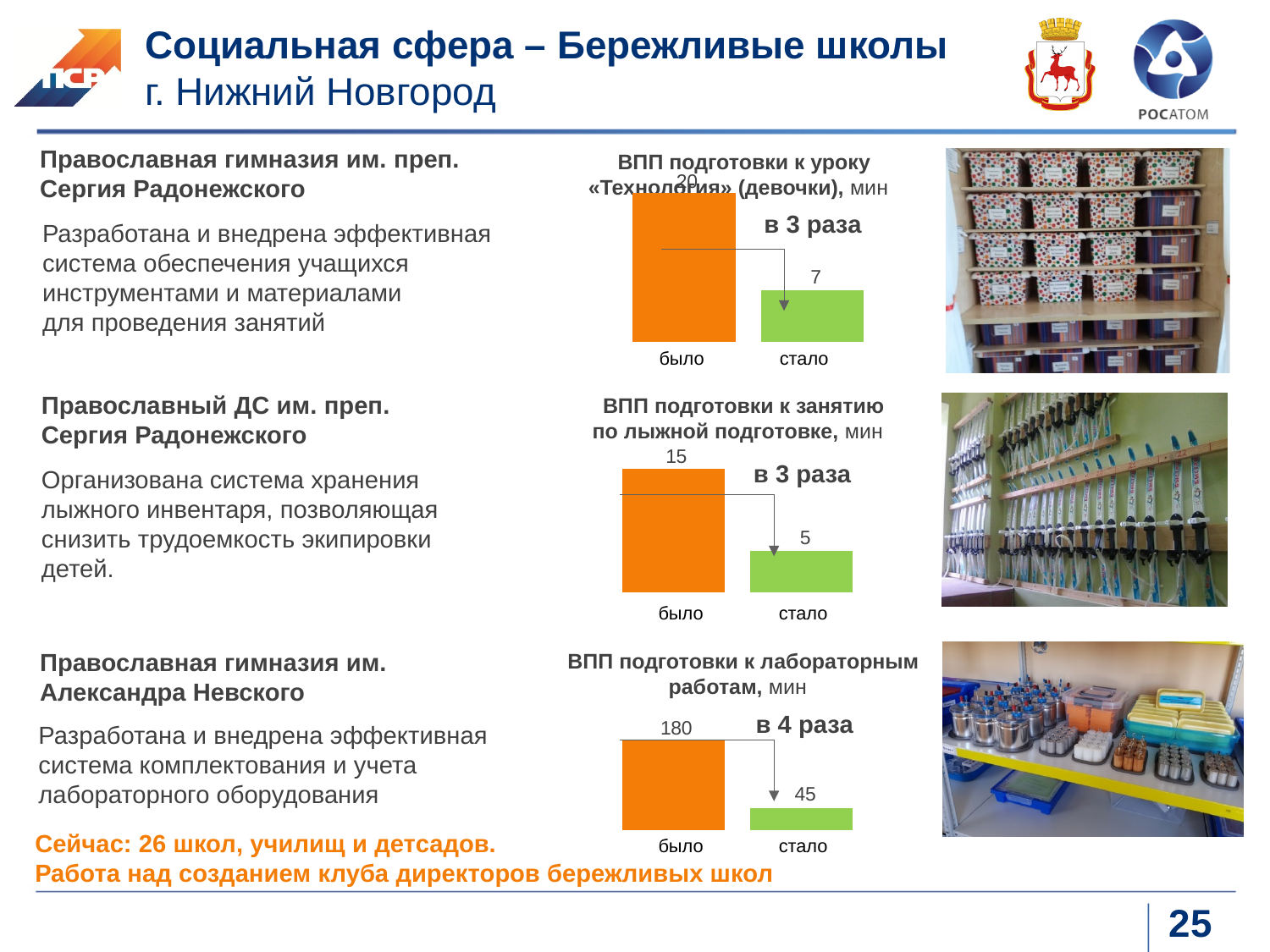
In the chart titled «ВПП подготовки к занятию по лыжной подготовке, мин», what is the difference between «было» and «стало»? 10 In the chart titled «ВПП подготовки к занятию по лыжной подготовке, мин», what is the value for «стало»? 5 How many categories are shown in the chart titled «ВПП подготовки к уроку «Технология» (девочки), мин»? 2 What kind of chart is the one titled «ВПП подготовки к лабораторным работам, мин»? bar chart In the chart titled «ВПП подготовки к занятию по лыжной подготовке, мин», which category has the lowest value? стало In the chart titled «ВПП подготовки к занятию по лыжной подготовке, мин», what is the value for «было»? 15 In the chart titled «ВПП подготовки к лабораторным работам, мин», what reduction factor is annotated between the bars? в 4 раза In the chart titled «ВПП подготовки к лабораторным работам, мин», what is the value for «было»? 180 In the chart titled «ВПП подготовки к лабораторным работам, мин», what is the value for «стало»? 45 In the chart titled «ВПП подготовки к уроку «Технология» (девочки), мин», what is the value for «стало»? 7 In the chart titled «ВПП подготовки к лабораторным работам, мин», what is the difference between «было» and «стало»? 135 In the chart titled «ВПП подготовки к лабораторным работам, мин», which category has the higher value, «было» or «стало»? было